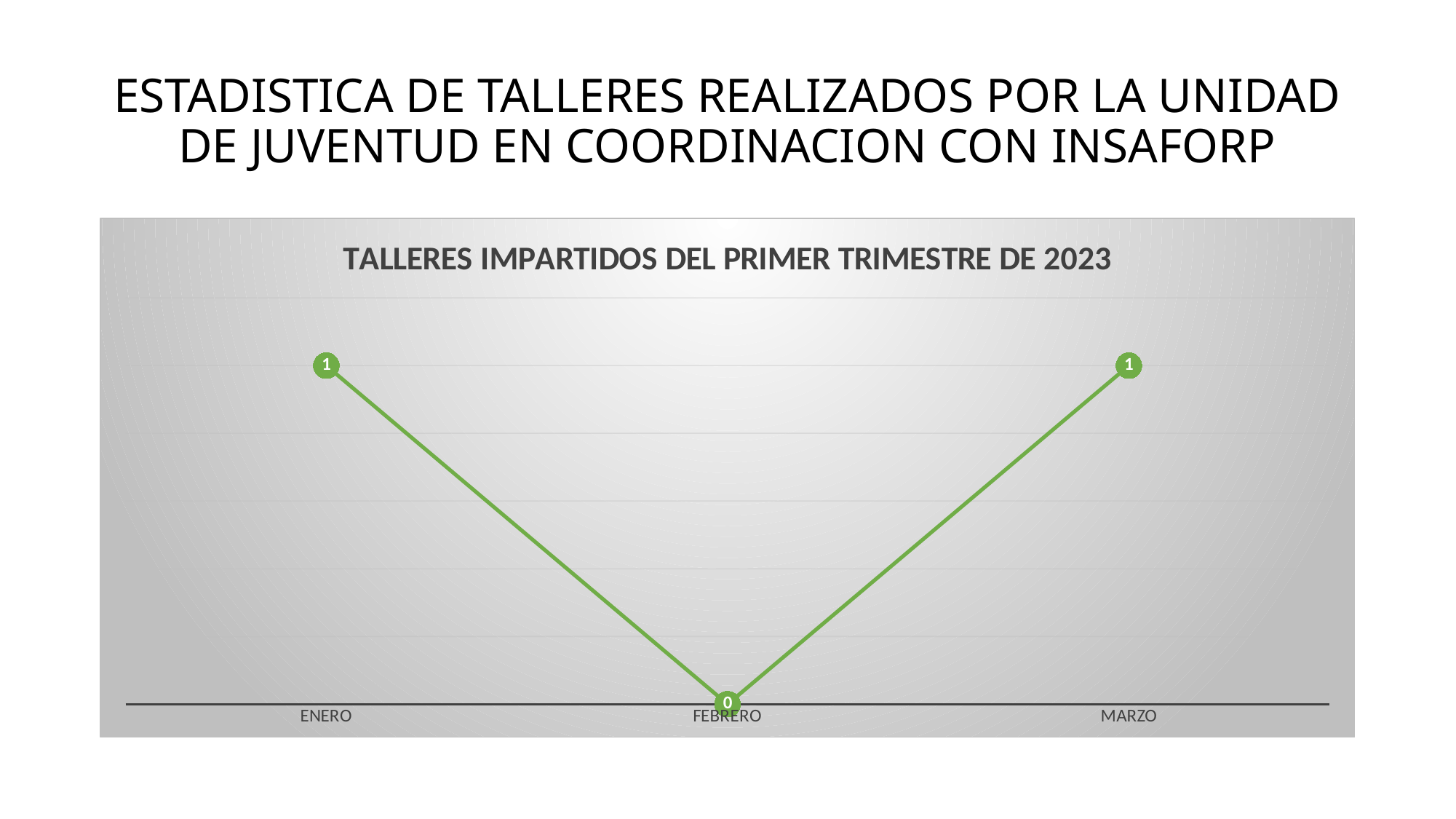
What is the difference between the values for ENERO and FEBRERO? 1 What is the title of the chart? TALLERES IMPARTIDOS DEL PRIMER TRIMESTRE DE 2023 Which is larger, the value for MARZO or the value for FEBRERO? MARZO What kind of chart is shown? line chart What is the value for FEBRERO? 0 What colour is the line on the chart? green Which month has the lowest value? FEBRERO What is the value for MARZO? 1 What is the value for ENERO? 1 How many months are plotted on the chart? 3 Do the values rise or fall from FEBRERO to MARZO? rise Do the values rise or fall from ENERO to FEBRERO? fall